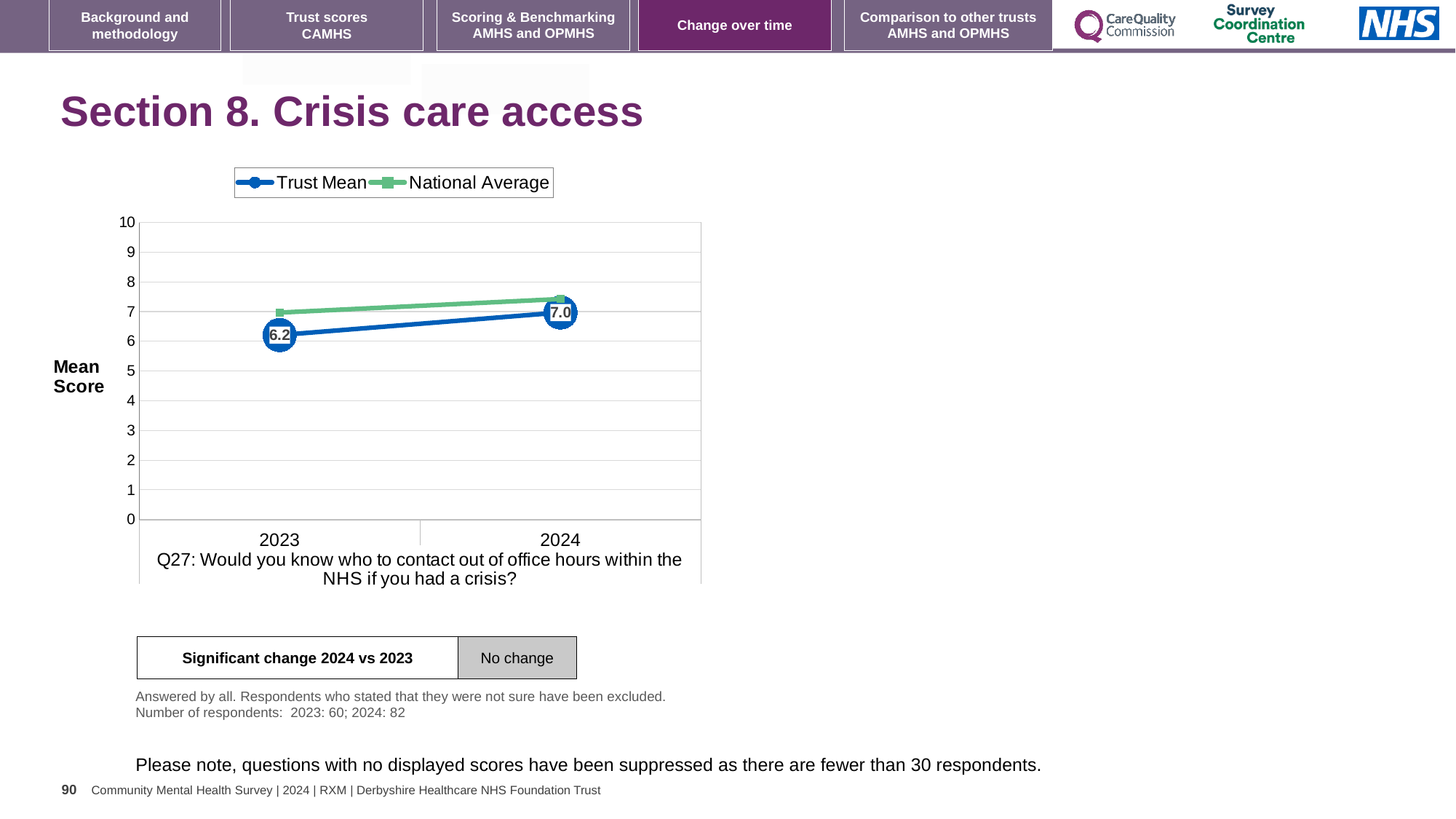
What is the Trust Mean score for 2023? 6.2 In 2023, which is higher: the Trust Mean or the National Average? National Average By how much did the Trust Mean score change from 2023 to 2024? 0.8 What is the label on the y axis of the chart? Mean Score Is the National Average value for 2024 greater or less than 8? less Is the National Average value for 2023 greater or less than 6? greater How many years are plotted on the x axis? 2 Does the Trust Mean rise or fall from 2023 to 2024? rise Which year has the higher Trust Mean score? 2024 What is the Trust Mean score for 2024? 7.0 What kind of chart is shown on the slide? line chart How many series does the legend list? 2